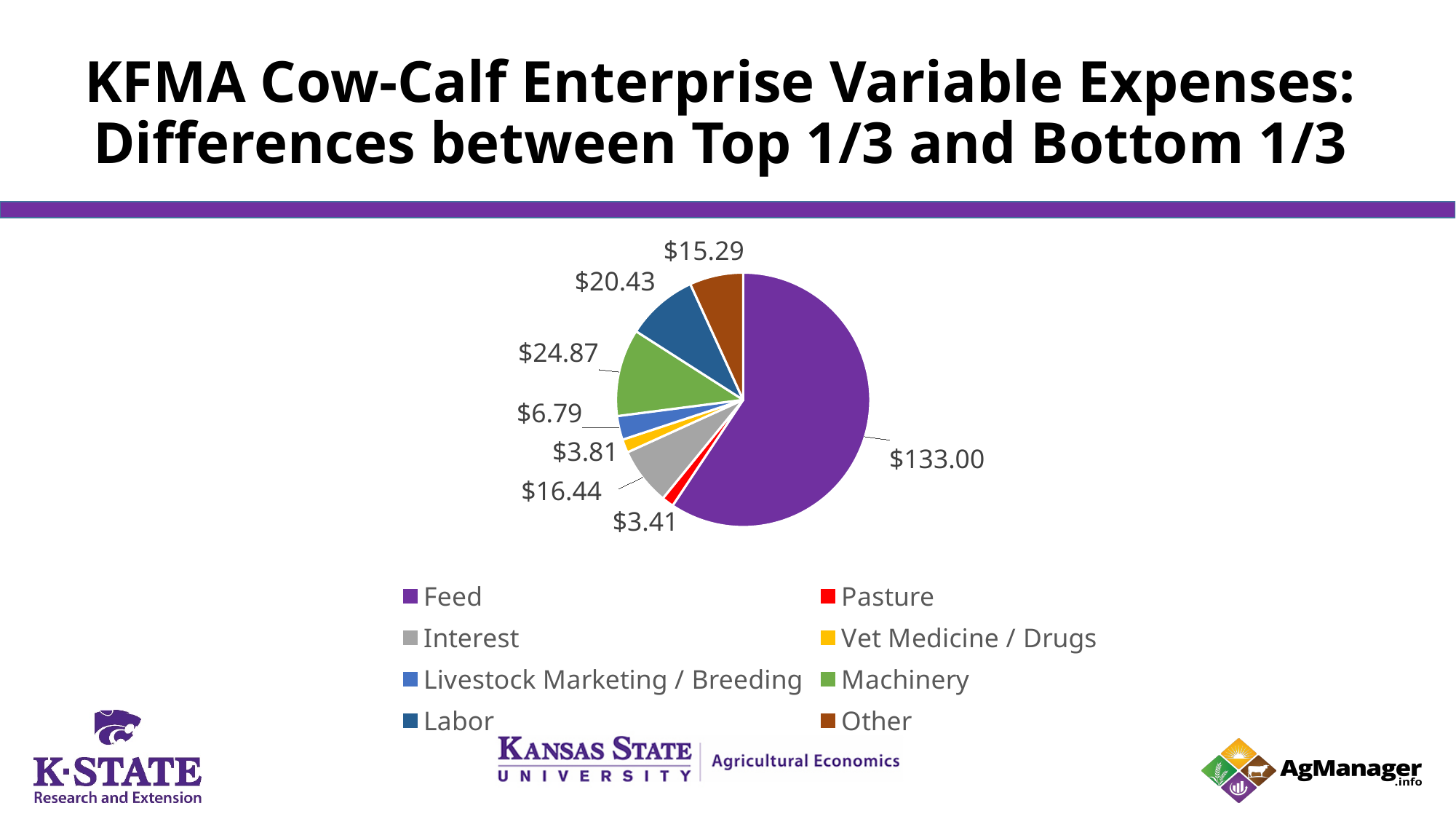
Which is larger, the Interest slice or the Other slice? Interest What is the difference between the Feed value and the Machinery value? $108.13 What is the value of the Feed slice? $133.00 How many categories does the pie chart show? 8 What is the difference between the Labor value and the Other value? $5.14 What is the value of the Pasture slice? $3.41 What is the value of the Machinery slice? $24.87 Which category has the smallest slice of the pie? Pasture What is the value of the Interest slice? $16.44 What type of chart is shown on the slide? Pie chart Which category has the largest slice of the pie? Feed What is the value of the Labor slice? $20.43